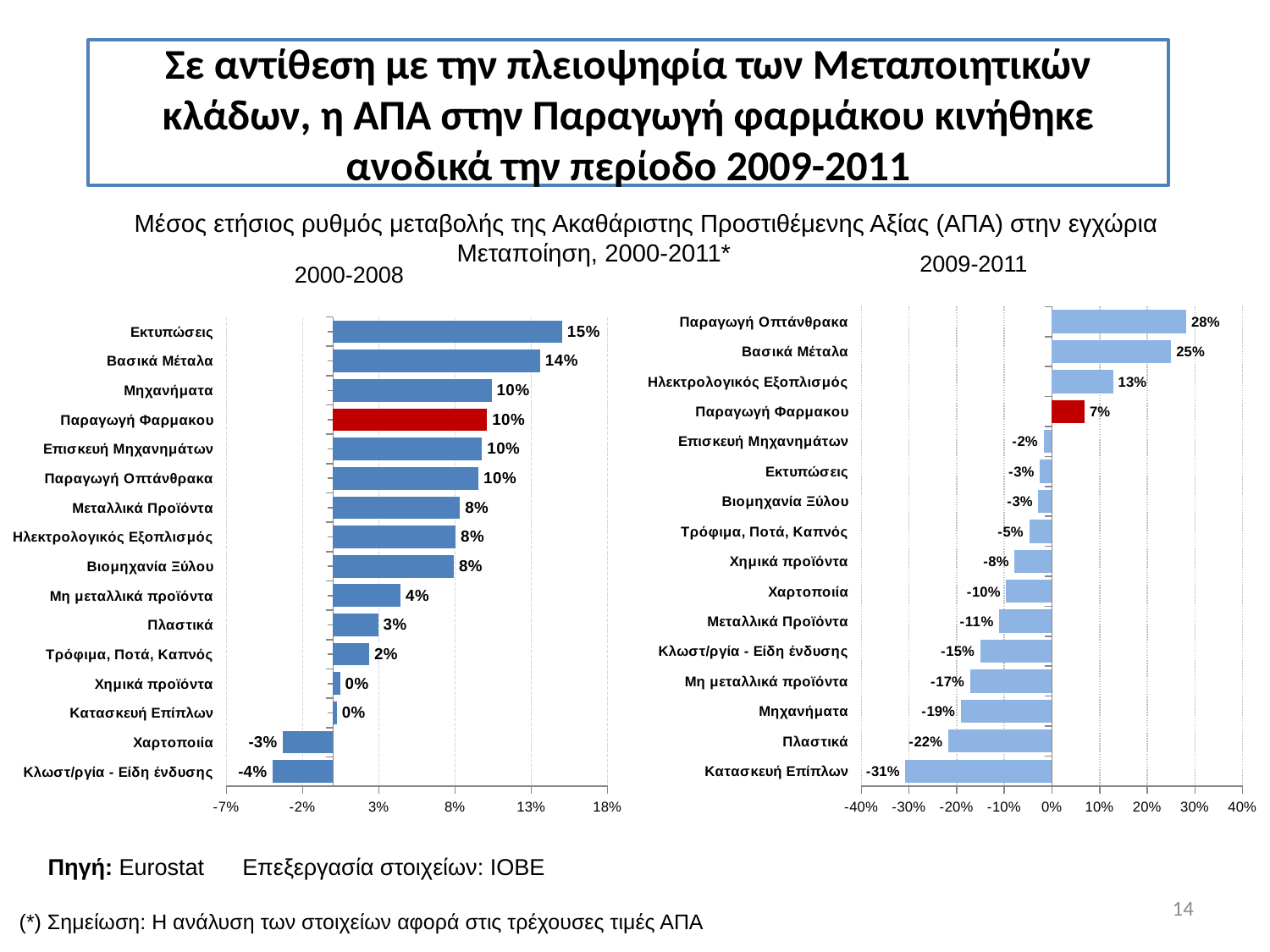
In the 2000-2008 chart, which category has the highest value? Εκτυπώσεις In the 2000-2008 chart, what is the value for Παραγωγή Φαρμάκου? 10% In the 2009-2011 chart, what is the difference between the values for Παραγωγή Οπτάνθρακα and Βασικά Μέταλλα? 3% How many categories are shown in the 2000-2008 chart? 16 What type of chart is the 2009-2011 chart? Bar chart In the 2009-2011 chart, which is larger: the value for Μηχανήματα or the value for Πλαστικά? Μηχανήματα In the 2009-2011 chart, which bar is highlighted in a different colour (red) from the others? Παραγωγή Φαρμάκου In the 2000-2008 chart, what is the difference between the values for Εκτυπώσεις and Βασικά Μέταλλα? 1% In the 2009-2011 chart, which category has the highest value? Παραγωγή Οπτάνθρακα In the 2009-2011 chart, what is the value for Παραγωγή Φαρμάκου? 7% In the 2000-2008 chart, what is the value for Κλωστ/ργία - Είδη ένδυσης? -4% In the 2009-2011 chart, which category has the lowest value? Κατασκευή Επίπλων